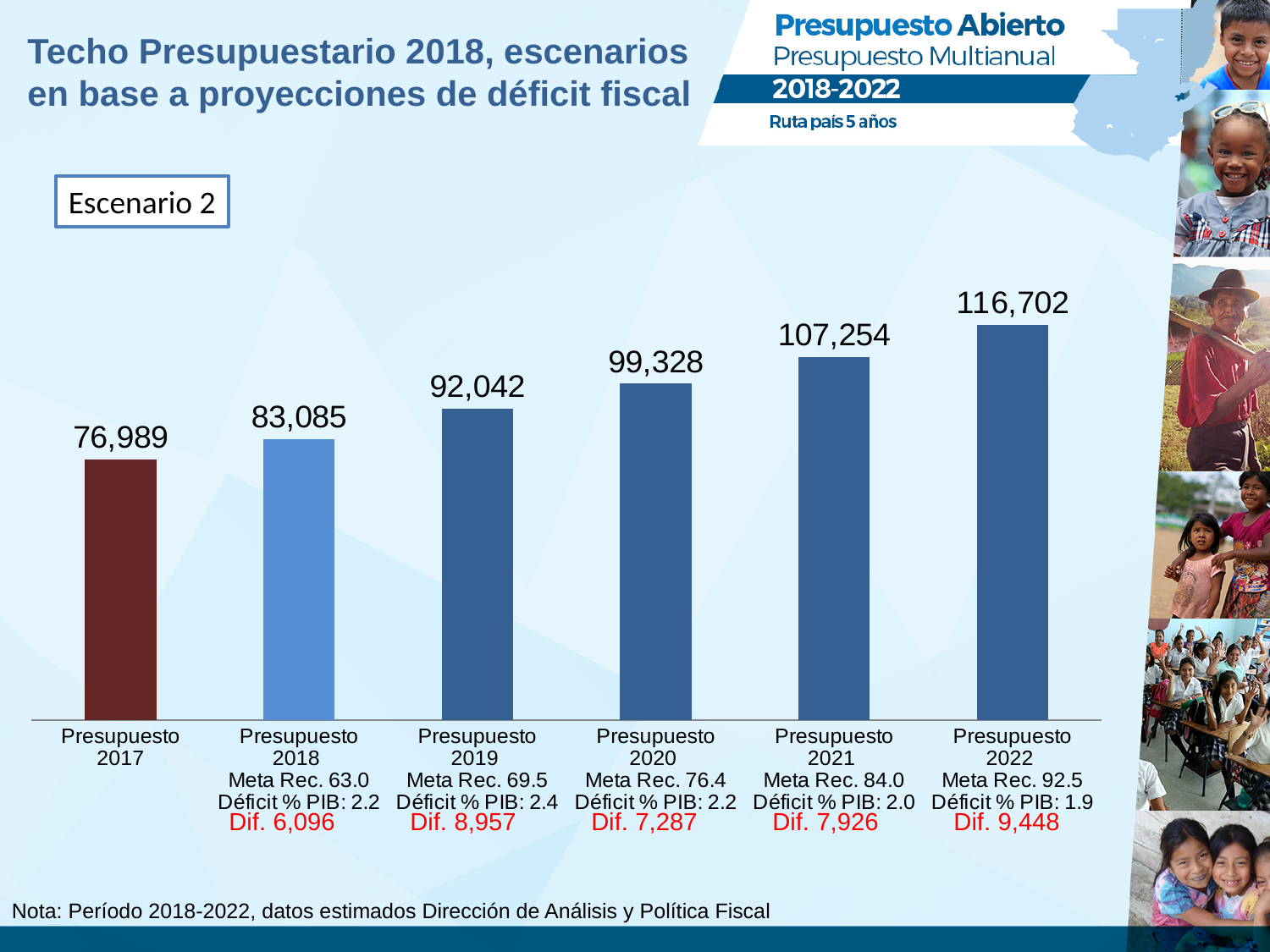
What is the value shown for Presupuesto 2017? 76,989 What is the Meta Rec. value printed under Presupuesto 2020? 76.4 What is the value shown for Presupuesto 2022? 116,702 Which category has the highest value? Presupuesto 2022 What kind of chart is shown on the slide? Bar chart What is the difference between the values for Presupuesto 2022 and Presupuesto 2021? 9,448 What is the value shown for Presupuesto 2020? 99,328 Which is larger, the value for Presupuesto 2019 or the value for Presupuesto 2021? Presupuesto 2021 Do the values rise or fall from Presupuesto 2017 to Presupuesto 2022? Rise What is the difference between the values for Presupuesto 2018 and Presupuesto 2017? 6,096 Which category has the lowest value? Presupuesto 2017 How many bars are shown in the chart? 6